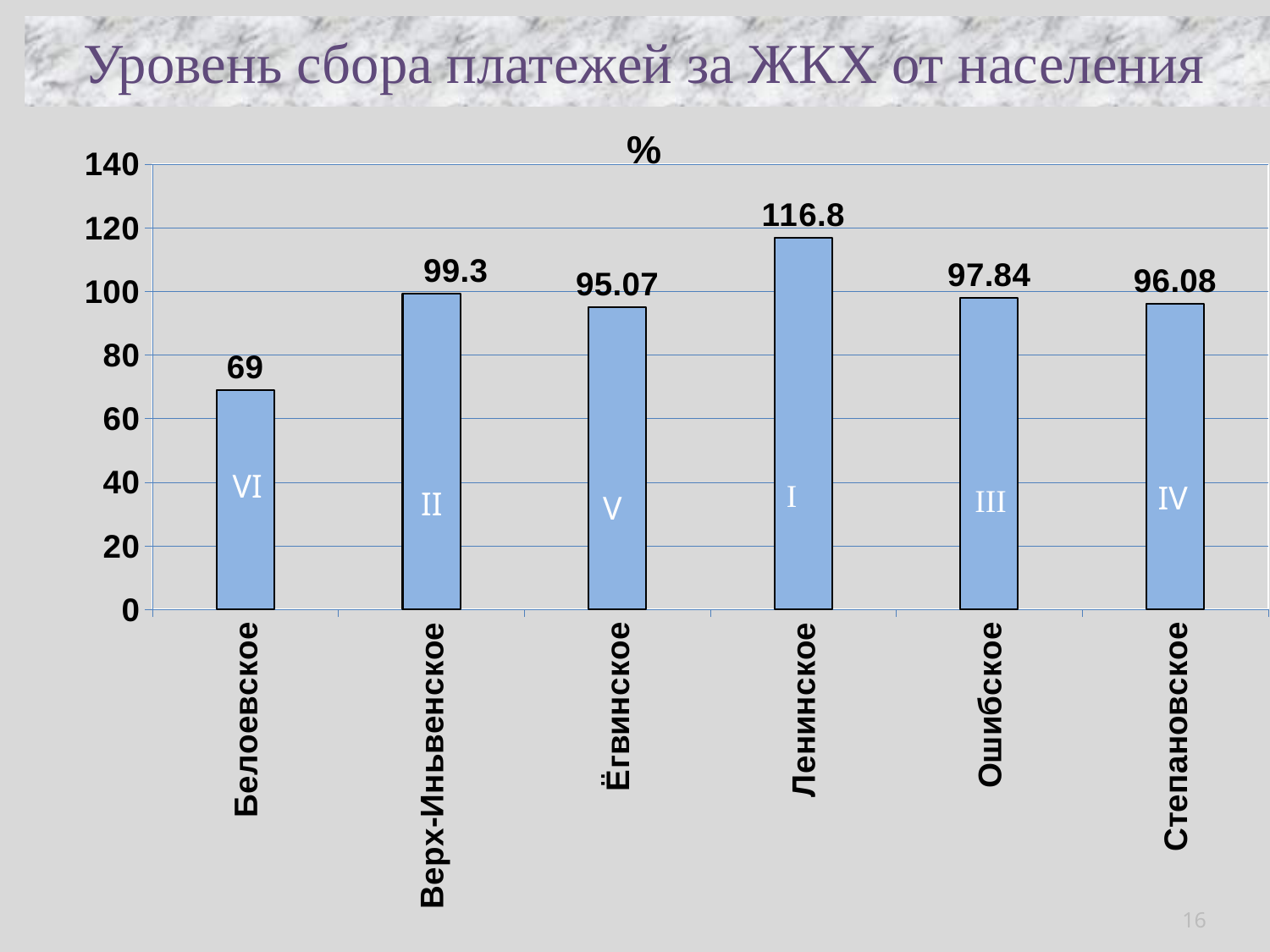
Which is larger, the value for Ошибское or the value for Степановское? Ошибское What is the difference between the values for Ленинское and Белоевское? 47.8 What is the title of the slide? Уровень сбора платежей за ЖКХ от населения Is the value for Верх-Иньвенское greater or less than 100? less What is the difference between the values for Верх-Иньвенское and Ёгвинское? 4.23 Which category has the highest value? Ленинское What is the value for Ленинское? 116.8 What kind of chart is shown on the slide? bar chart What is the value for Белоевское? 69 Which category has the lowest value? Белоевское How many categories are shown on the chart? 6 What is the value for Ошибское? 97.84